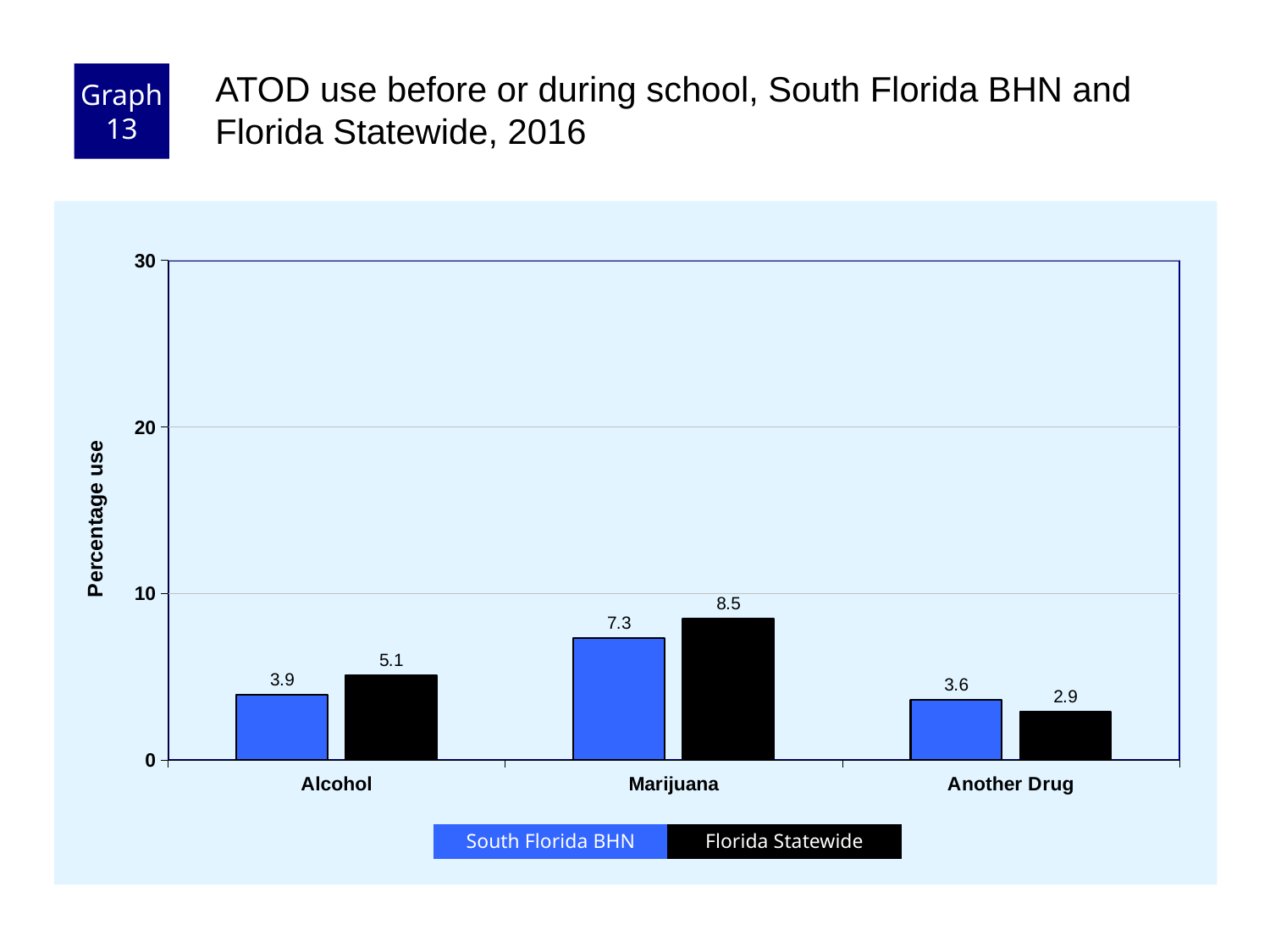
For Alcohol, which is larger: South Florida BHN or Florida Statewide? Florida Statewide Which category has the lowest South Florida BHN value? Another Drug How many series does the legend list? 2 How many categories are shown on the x axis? 3 What is the South Florida BHN value for Marijuana? 7.3 What is the Florida Statewide value for Another Drug? 2.9 Which category has the highest Florida Statewide value? Marijuana What is the Florida Statewide value for Alcohol? 5.1 What is the difference between the South Florida BHN and Florida Statewide values for Another Drug? 0.7 Is the Florida Statewide value for Marijuana greater or less than 10? less What kind of chart is shown on the slide? bar chart What is the difference between the Florida Statewide and South Florida BHN values for Marijuana? 1.2